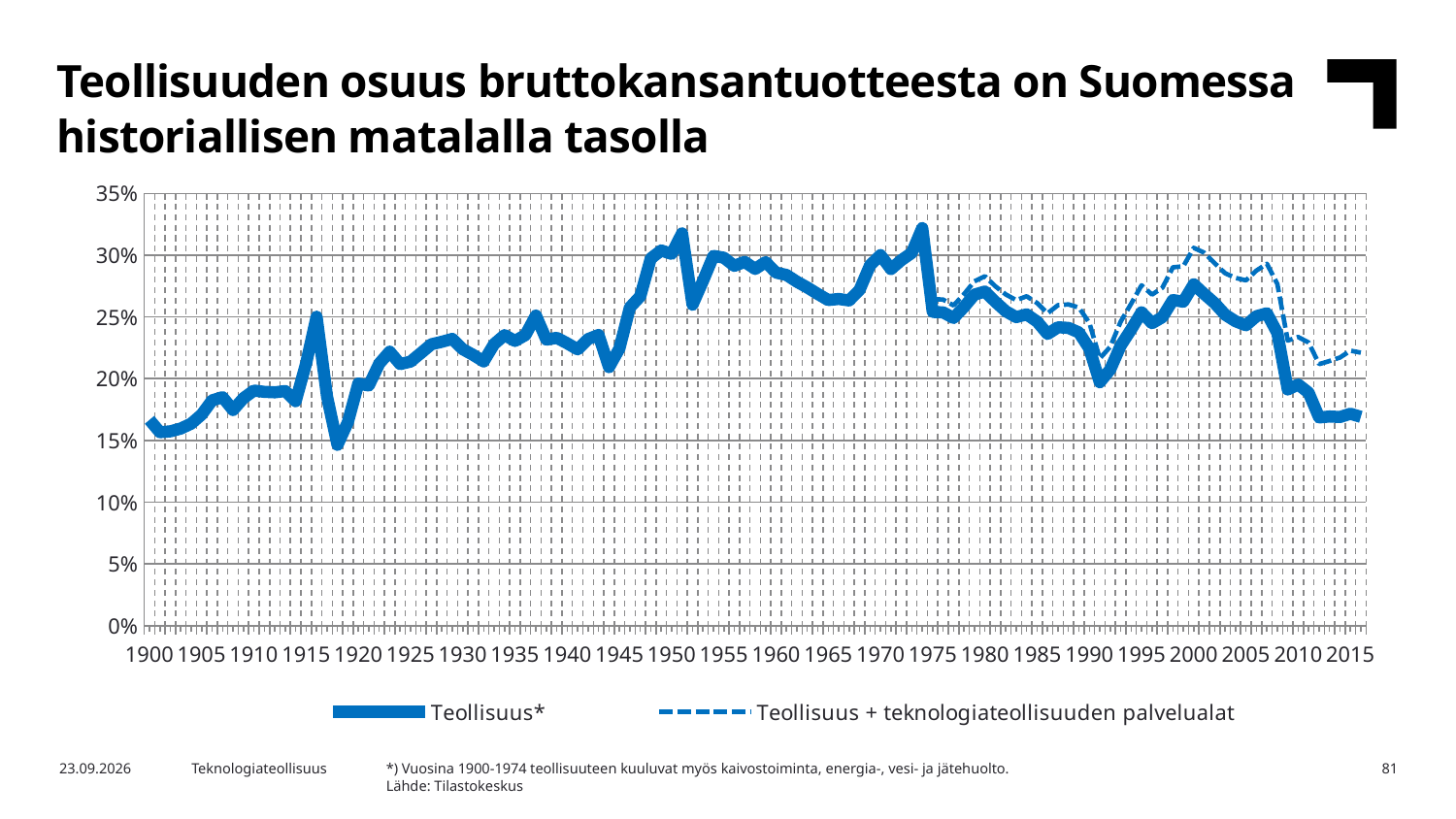
Does the Teollisuus* line rise or fall between 1945 and 1950? Rise In 2015, which series has the higher value: Teollisuus* or Teollisuus + teknologiateollisuuden palvelualat? Teollisuus + teknologiateollisuuden palvelualat What is the highest value shown on the y axis? 35% Is the value for Teollisuus* in 1900 greater or less than 20%? less Is the value for Teollisuus + teknologiateollisuuden palvelualat in 2015 greater or less than 20%? greater What kind of chart is shown on the slide? Line chart Is the value for Teollisuus* in 2015 greater or less than 20%? less Does the Teollisuus* line rise or fall between 2005 and 2015? Fall What is the title of the chart on the slide? Teollisuuden osuus bruttokansantuotteesta on Suomessa historiallisen matalalla tasolla Which series is drawn with a dashed line? Teollisuus + teknologiateollisuuden palvelualat How many series does the legend list? 2